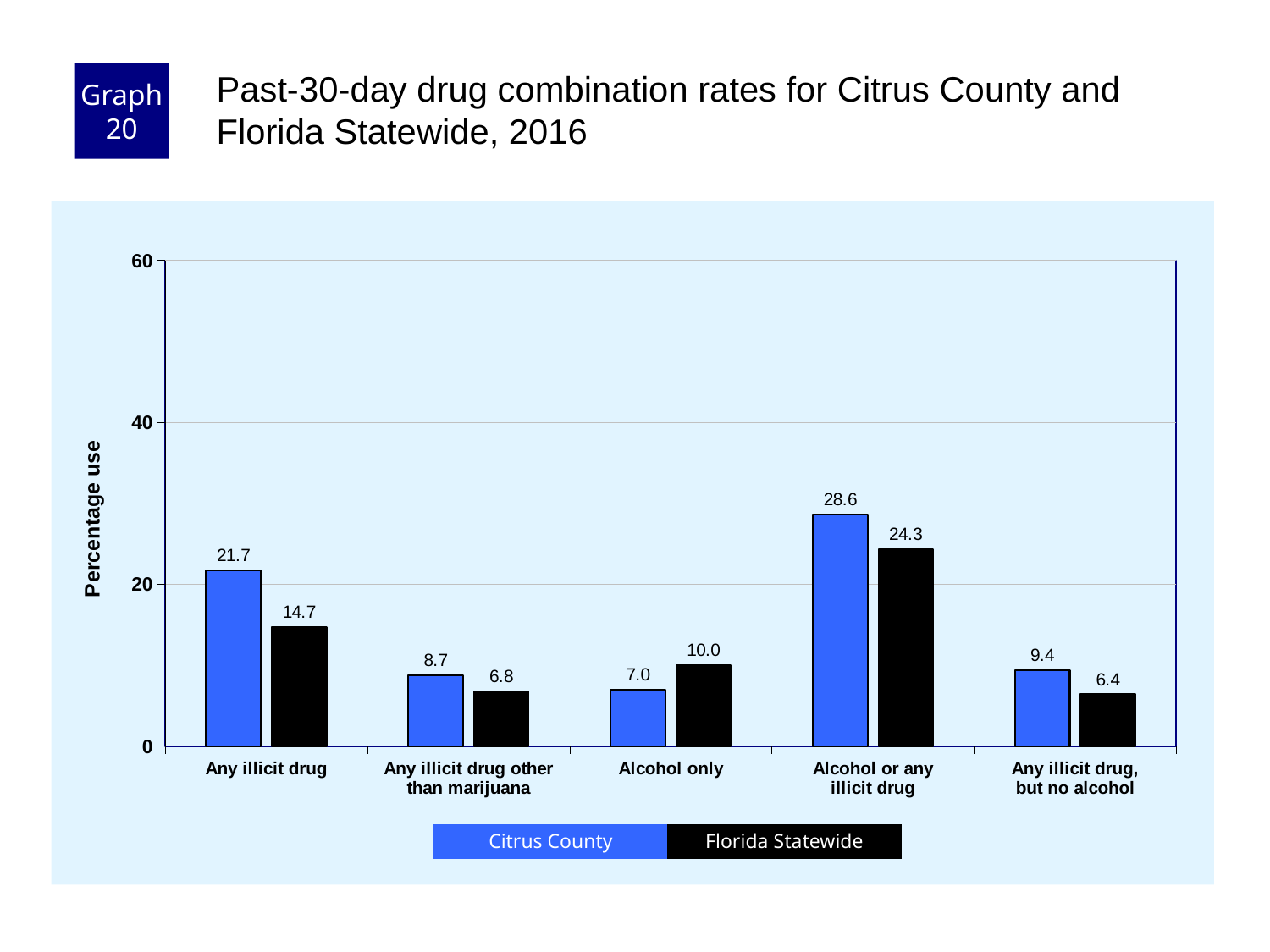
What is the difference between the Citrus County and Florida Statewide values for Any illicit drug? 7.0 What kind of chart is shown on the slide? Bar chart How many categories are shown on the x axis? 5 Which category has the lowest Florida Statewide value? Any illicit drug, but no alcohol Is the Citrus County value for Alcohol or any illicit drug greater or less than 20? greater Which category has the highest Citrus County value? Alcohol or any illicit drug For Alcohol only, which is larger: Citrus County or Florida Statewide? Florida Statewide What is the difference between the Citrus County and Florida Statewide values for Alcohol or any illicit drug? 4.3 How many series does the legend list? 2 What is the Citrus County value for Any illicit drug? 21.7 What is the Florida Statewide value for Alcohol only? 10.0 What is the Florida Statewide value for Any illicit drug, but no alcohol? 6.4